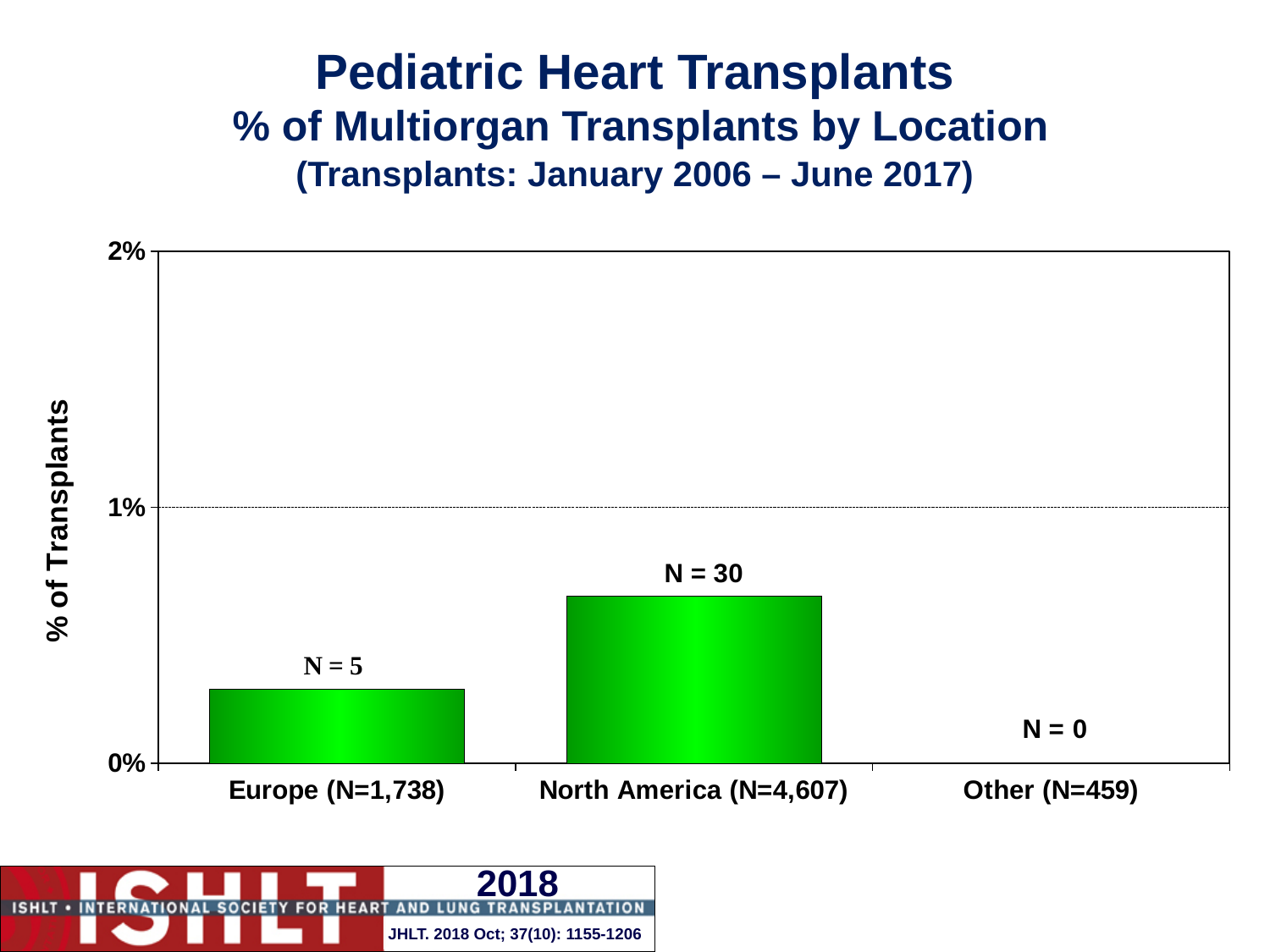
Which location has the highest % of multiorgan transplants? North America (N=4,607) Which location has the lowest % of multiorgan transplants? Other (N=459) Is the % of transplants for Europe greater or less than 1%? less What kind of chart is shown on the slide? bar chart What is the label on the y axis? % of Transplants Which has a larger % of multiorgan transplants, Europe or North America? North America What is the total N shown in the x-axis label for North America? N=4,607 Is the % of transplants for North America greater or less than 1%? less What is the N value printed above the bar for Europe? N = 5 What is the N value printed above the bar for North America? N = 30 How many location categories are shown on the x axis? 3 What is the N value printed for the Other category? N = 0